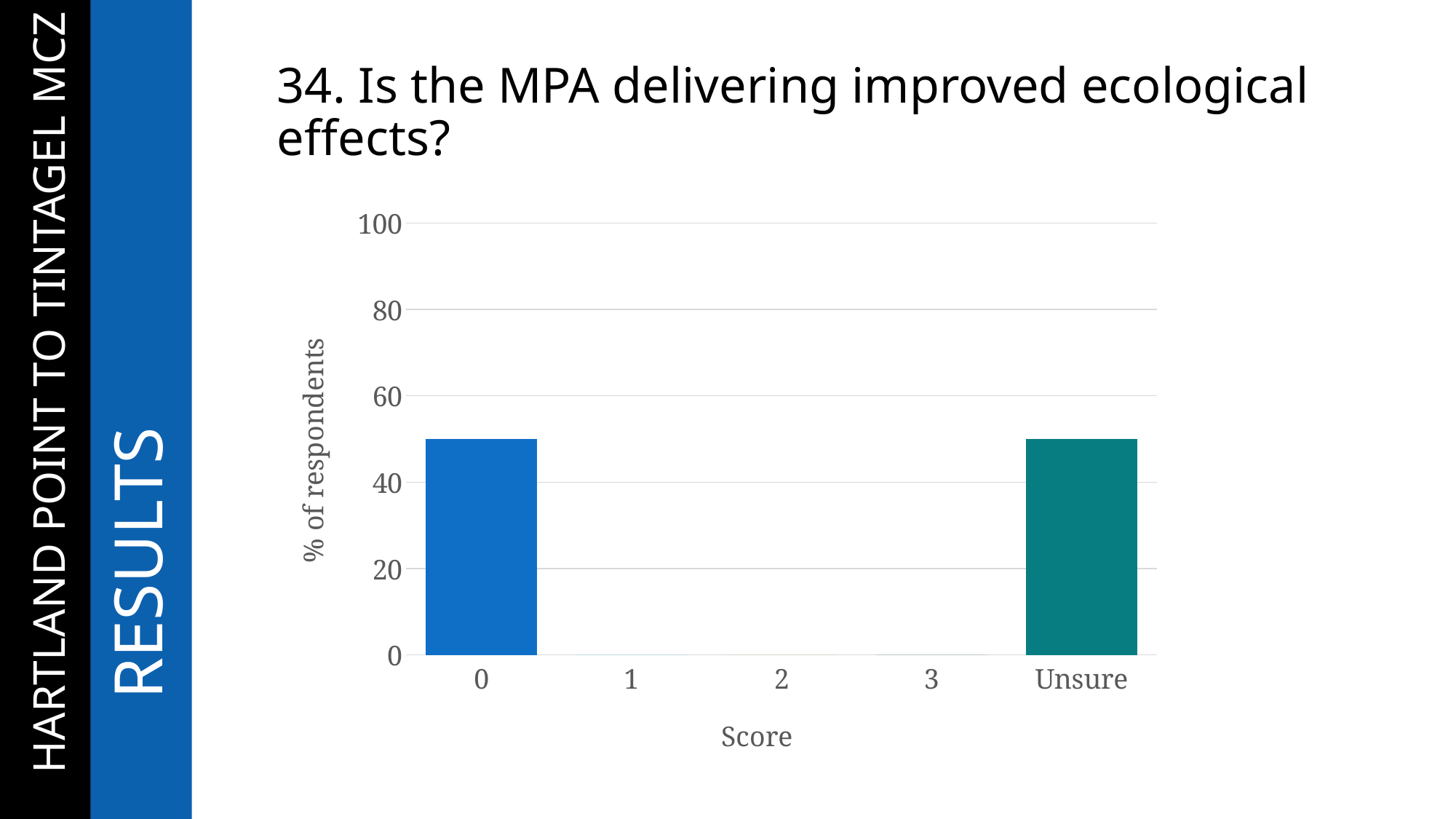
Is the value for score 0 greater or less than 60? less What is the label of the y axis? % of respondents Is the value for Unsure greater or less than 40? greater Which has a larger value, score 0 or score 2? 0 What is the % of respondents for score 3? 0 How many score categories are shown on the x axis? 5 What is the label of the x axis? Score Is the value for Unsure greater or less than 60? less What is the % of respondents for score 1? 0 Which has a larger value, Unsure or score 3? Unsure What kind of chart is shown on the slide? bar chart